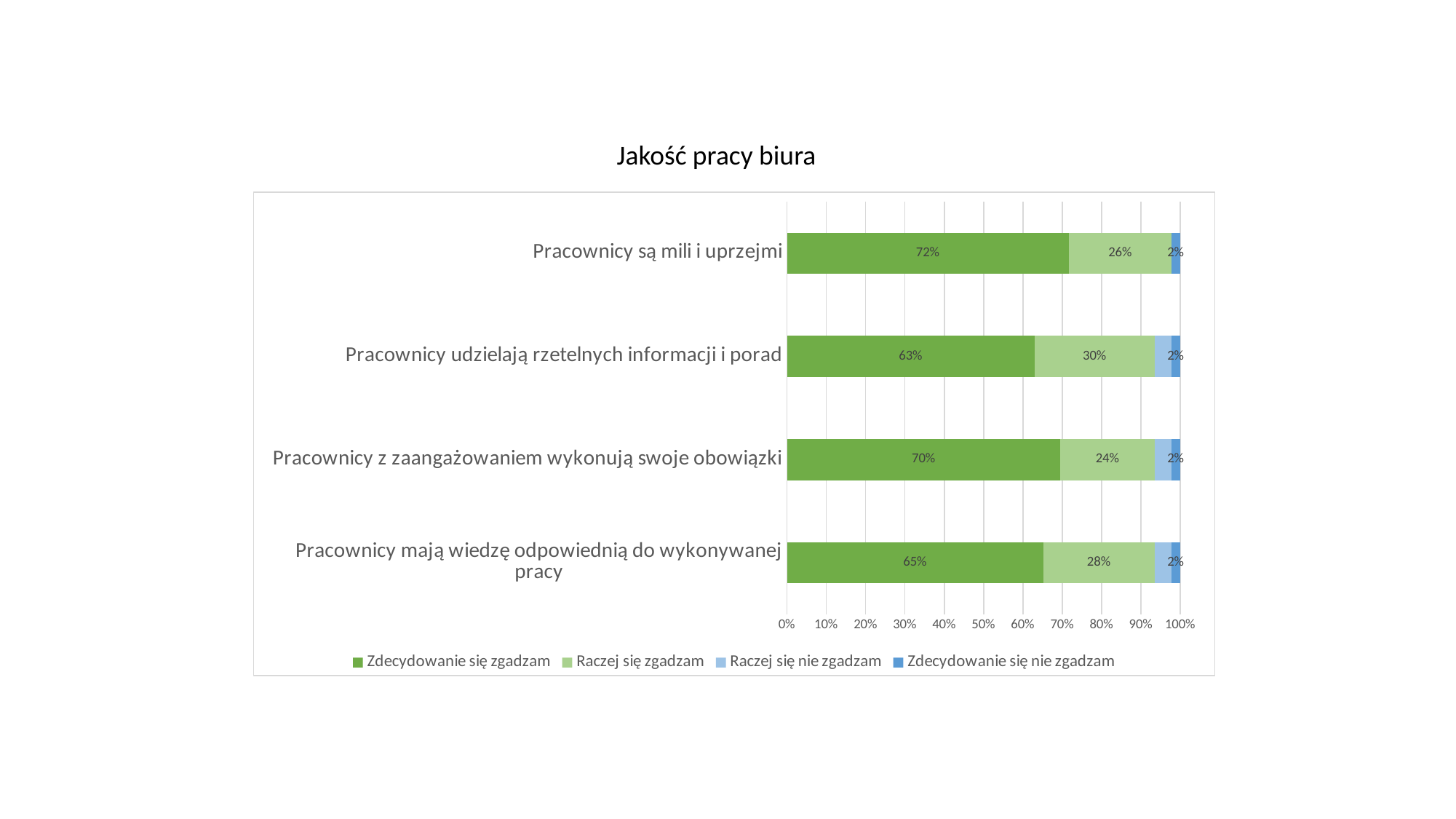
What is the value of "Zdecydowanie się zgadzam" for "Pracownicy są mili i uprzejmi"? 72% What is the value of "Raczej się zgadzam" for "Pracownicy udzielają rzetelnych informacji i porad"? 30% What kind of chart is shown on the slide? Stacked bar chart Which statement has the highest "Zdecydowanie się zgadzam" value? Pracownicy są mili i uprzejmi What is the value of "Zdecydowanie się zgadzam" for "Pracownicy z zaangażowaniem wykonują swoje obowiązki"? 70% What is the value of "Raczej się zgadzam" for "Pracownicy mają wiedzę odpowiednią do wykonywanej pracy"? 28% How many statements (categories) are shown in the chart? 4 Which has the larger "Raczej się zgadzam" value: "Pracownicy udzielają rzetelnych informacji i porad" or "Pracownicy z zaangażowaniem wykonują swoje obowiązki"? Pracownicy udzielają rzetelnych informacji i porad What is the difference in "Zdecydowanie się zgadzam" between "Pracownicy są mili i uprzejmi" and "Pracownicy udzielają rzetelnych informacji i porad"? 9 percentage points Which statement has the lowest "Zdecydowanie się zgadzam" value? Pracownicy udzielają rzetelnych informacji i porad How many series does the legend list? 4 What is the title of the chart? Jakość pracy biura